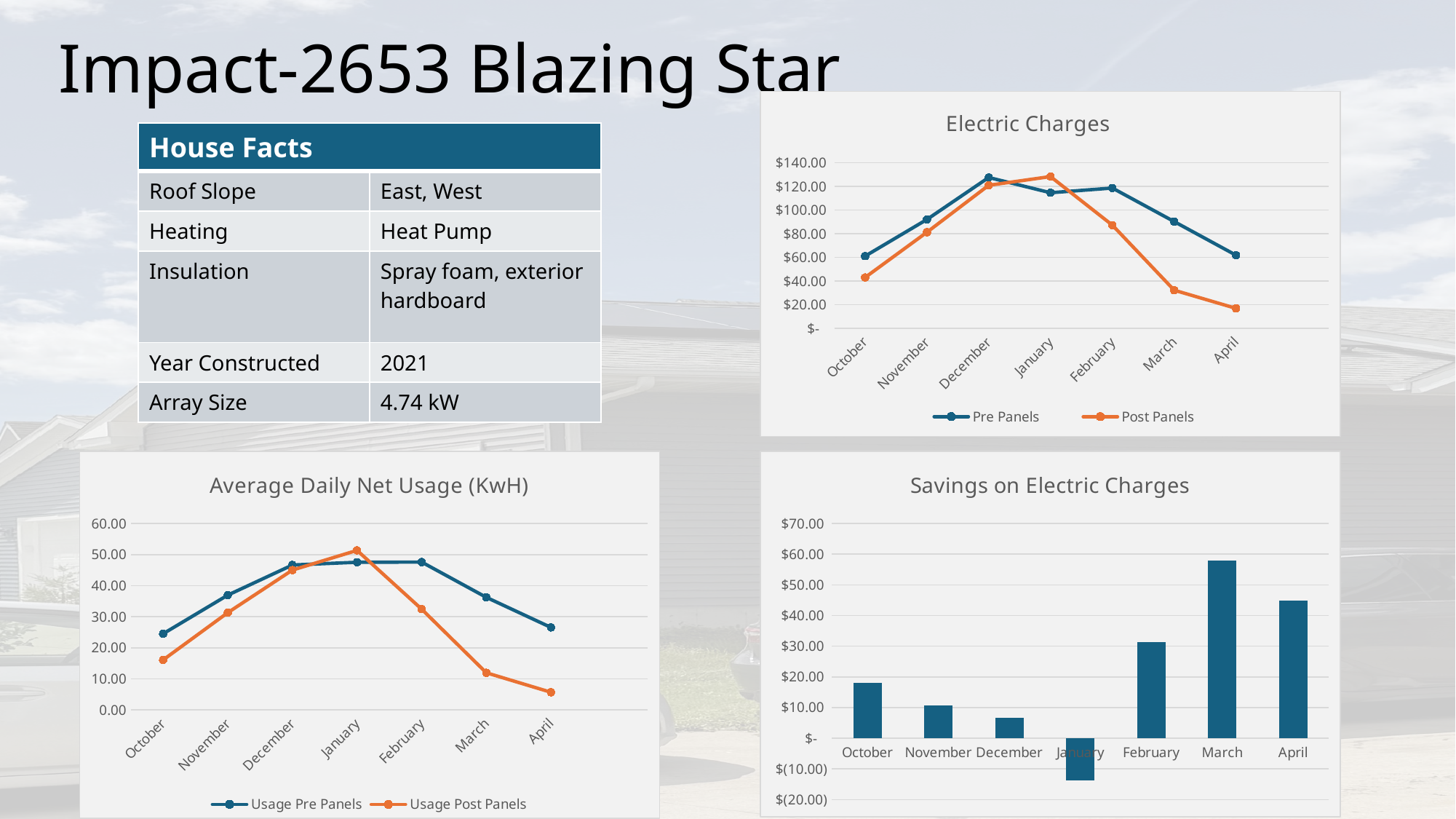
How many series does the legend of the "Average Daily Net Usage (KwH)" chart list? 2 In the "Savings on Electric Charges" chart, which month has the lowest value? January In the "Savings on Electric Charges" chart, is the value for March greater or less than $50.00? greater What kind of chart is the "Electric Charges" chart? line chart In the "Electric Charges" chart, which series is larger in March, Pre Panels or Post Panels? Pre Panels In the "Electric Charges" chart, which month has the highest Pre Panels value? December What kind of chart is the "Savings on Electric Charges" chart? bar chart In the "Electric Charges" chart, is the Post Panels value for March greater or less than $40.00? less In the "Electric Charges" chart, which month has the lowest Post Panels value? April In the "Average Daily Net Usage (KwH)" chart, is the Usage Post Panels value for April greater or less than 10.00? less In the "Savings on Electric Charges" chart, which month has the highest savings? March In the "Savings on Electric Charges" chart, how many months are shown? 7